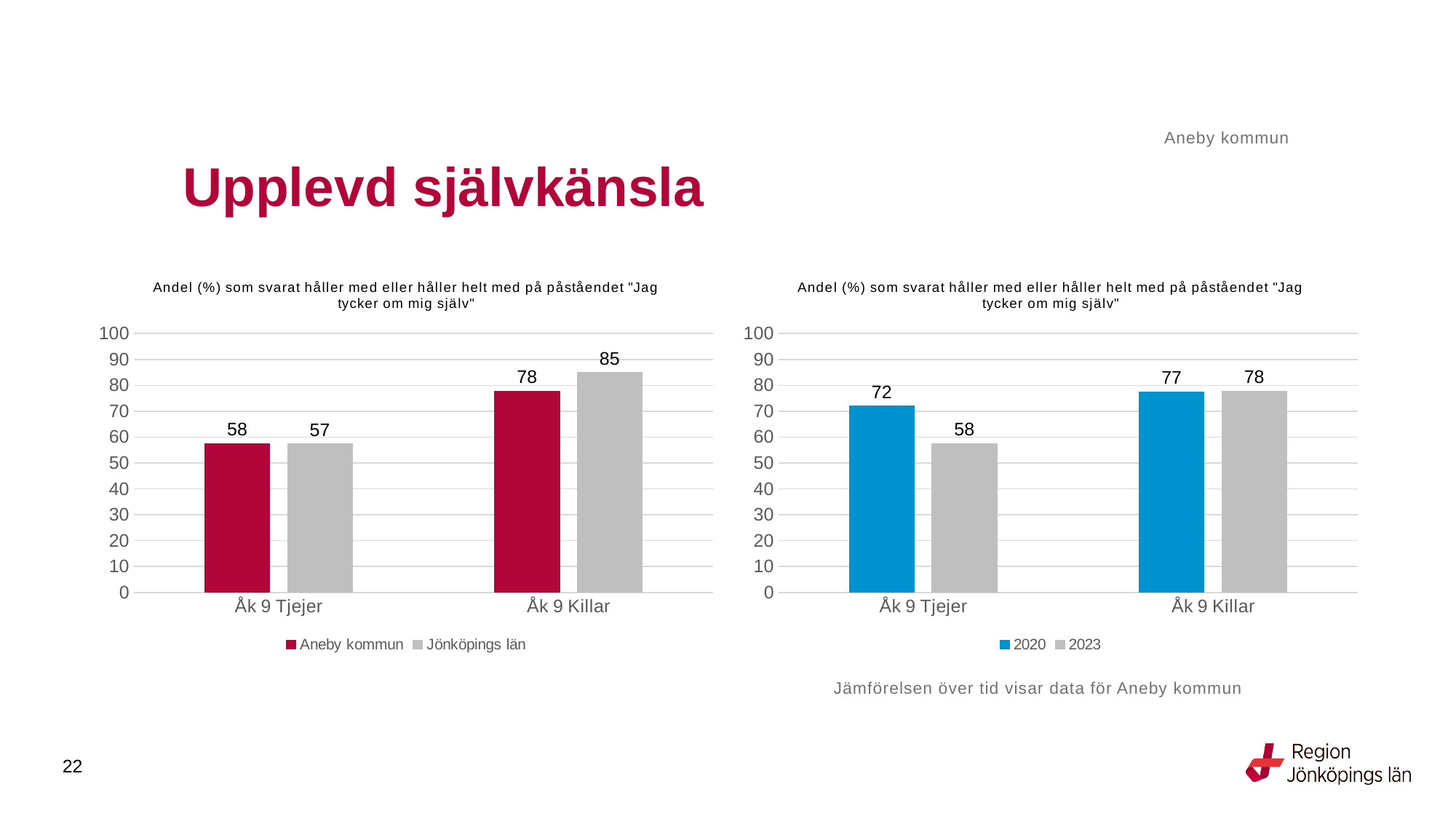
In the right chart, which bar is the lowest? 2023 for Åk 9 Tjejer In the left chart, which is larger for Åk 9 Tjejer: Aneby kommun or Jönköpings län? Aneby kommun In the left chart, what is the difference between Jönköpings län and Aneby kommun for Åk 9 Killar? 7 In the right chart, what is the value for 2020 for Åk 9 Tjejer? 72 In the left chart, what is the value for Aneby kommun for Åk 9 Tjejer? 58 How many series does the legend of the right chart list? 2 What kind of chart is the left chart? Bar chart In the right chart, what is the value for 2023 for Åk 9 Killar? 78 In the right chart, what is the difference between the 2020 and 2023 values for Åk 9 Tjejer? 14 In the left chart, what is the value for Jönköpings län for Åk 9 Killar? 85 In the left chart, which bar is the highest? Jönköpings län for Åk 9 Killar What are the two series listed in the legend of the left chart? Aneby kommun and Jönköpings län